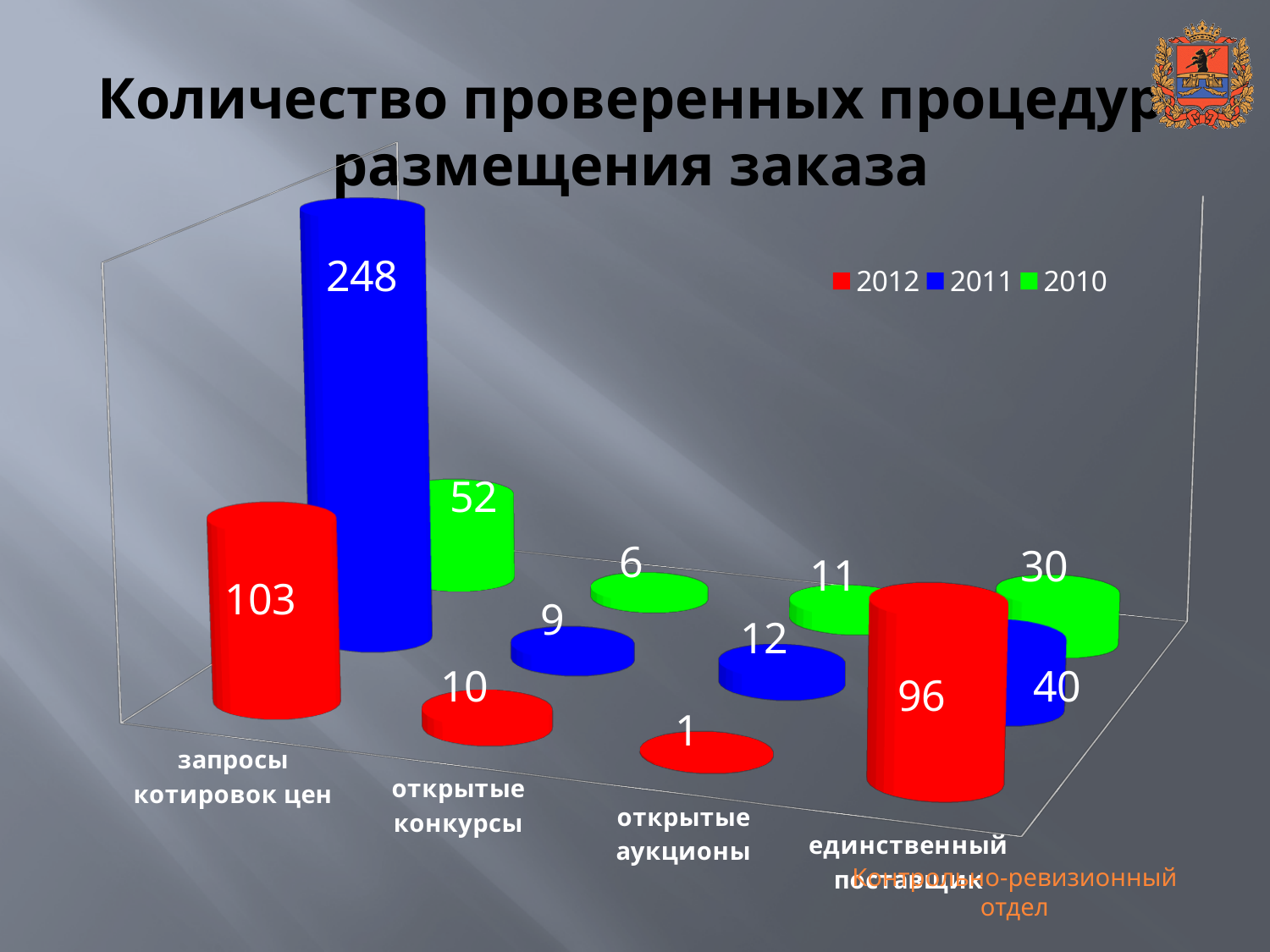
Which category has the highest value for the 2011 series? запросы котировок цен Which category has the lowest value for the 2012 series? открытые аукционы What is the value for 2011 in the category «запросы котировок цен»? 248 Which is larger for «единственный поставщик»: the 2011 value or the 2010 value? 2011 What kind of chart is shown on the slide? bar chart How many series does the legend list? 3 What is the value for 2012 in the category «единственный поставщик»? 96 How many categories are shown on the x axis? 4 What is the value for 2010 in the category «открытые аукционы»? 11 What is the difference between the 2011 and 2012 values for «запросы котировок цен»? 145 Which colour represents the 2010 series in the legend? green What is the total of the three series values for «открытые конкурсы»? 25